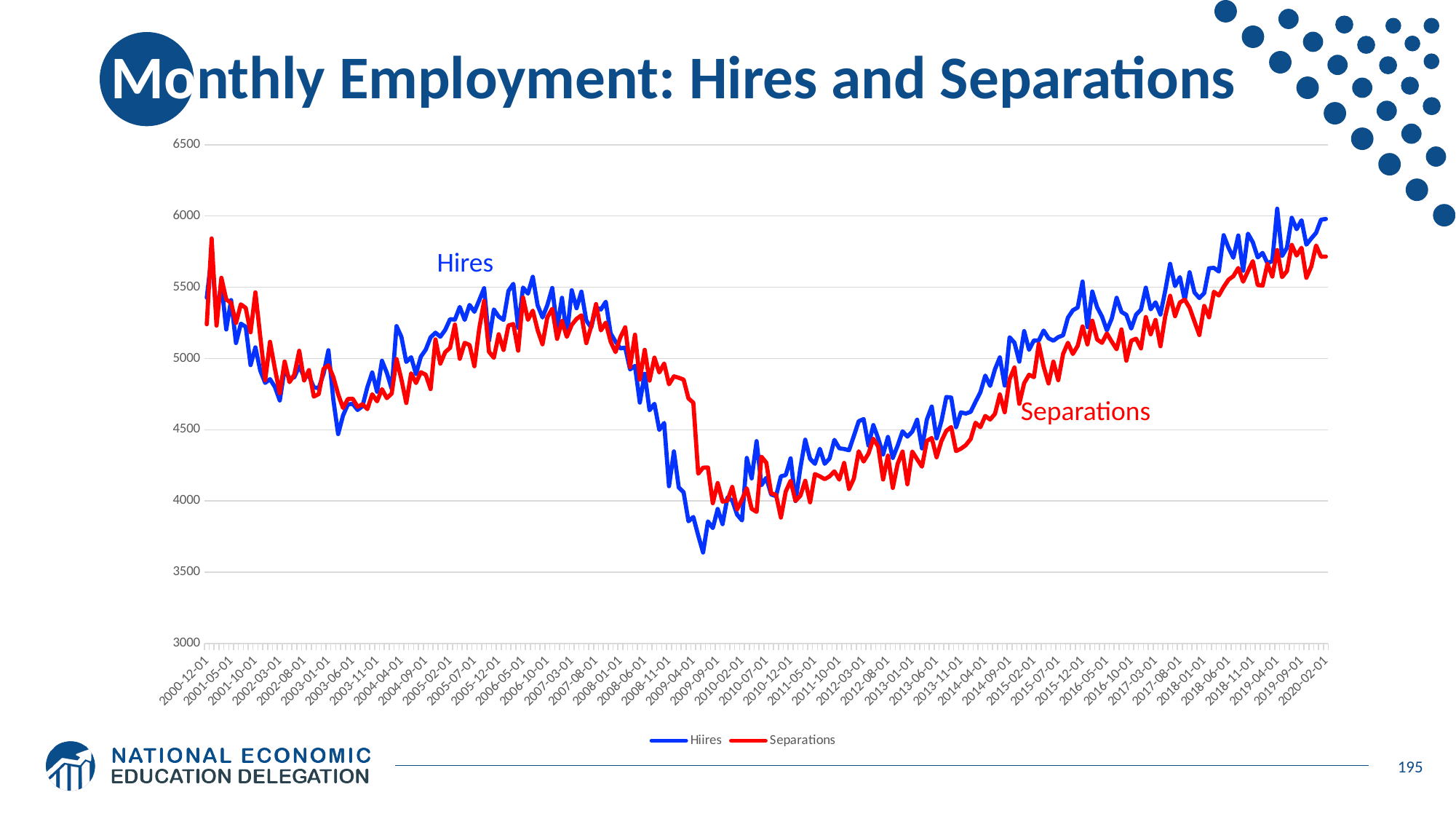
Is the value for Hires at 2005-07-01 greater or less than 5000? greater How many series does the legend list? 2 What is the highest value shown on the vertical axis? 6500 Which series reaches the lowest value on the chart? Hires Is the value for Hires at 2020-02-01 greater or less than 5500? greater Is the value for Separations at 2012-03-01 greater or less than 4500? less What kind of chart is shown on the slide? Line chart At 2020-02-01, which series has the higher value, Hires or Separations? Hires Do the Hires values rise or fall between 2009-09-01 and 2020-02-01? Rise What colour is the Separations line? Red